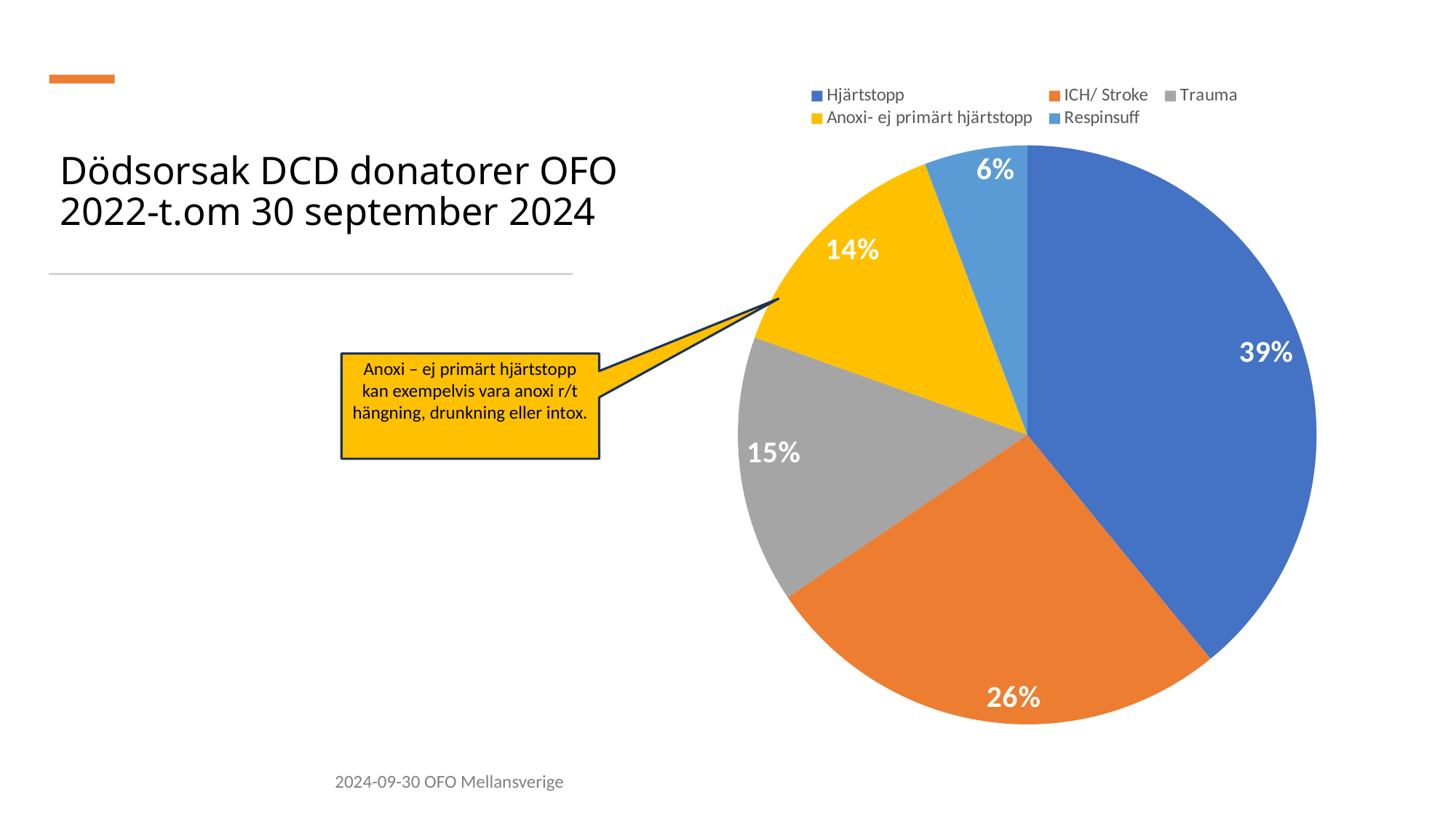
What is the value shown for Anoxi- ej primärt hjärtstopp? 14% What is the value shown for Trauma? 15% Which category has the largest slice of the pie? Hjärtstopp What share of the pie does Hjärtstopp account for? 39% What is the value shown for ICH/ Stroke? 26% How many categories does the pie chart have? 5 What is the value shown for Respinsuff? 6% What is the difference between the Hjärtstopp and ICH/ Stroke shares? 13% What colour is the Anoxi- ej primärt hjärtstopp slice? yellow What type of chart is shown on the slide? pie chart Which category has the smallest slice of the pie? Respinsuff Which is larger, the share for Trauma or the share for Respinsuff? Trauma